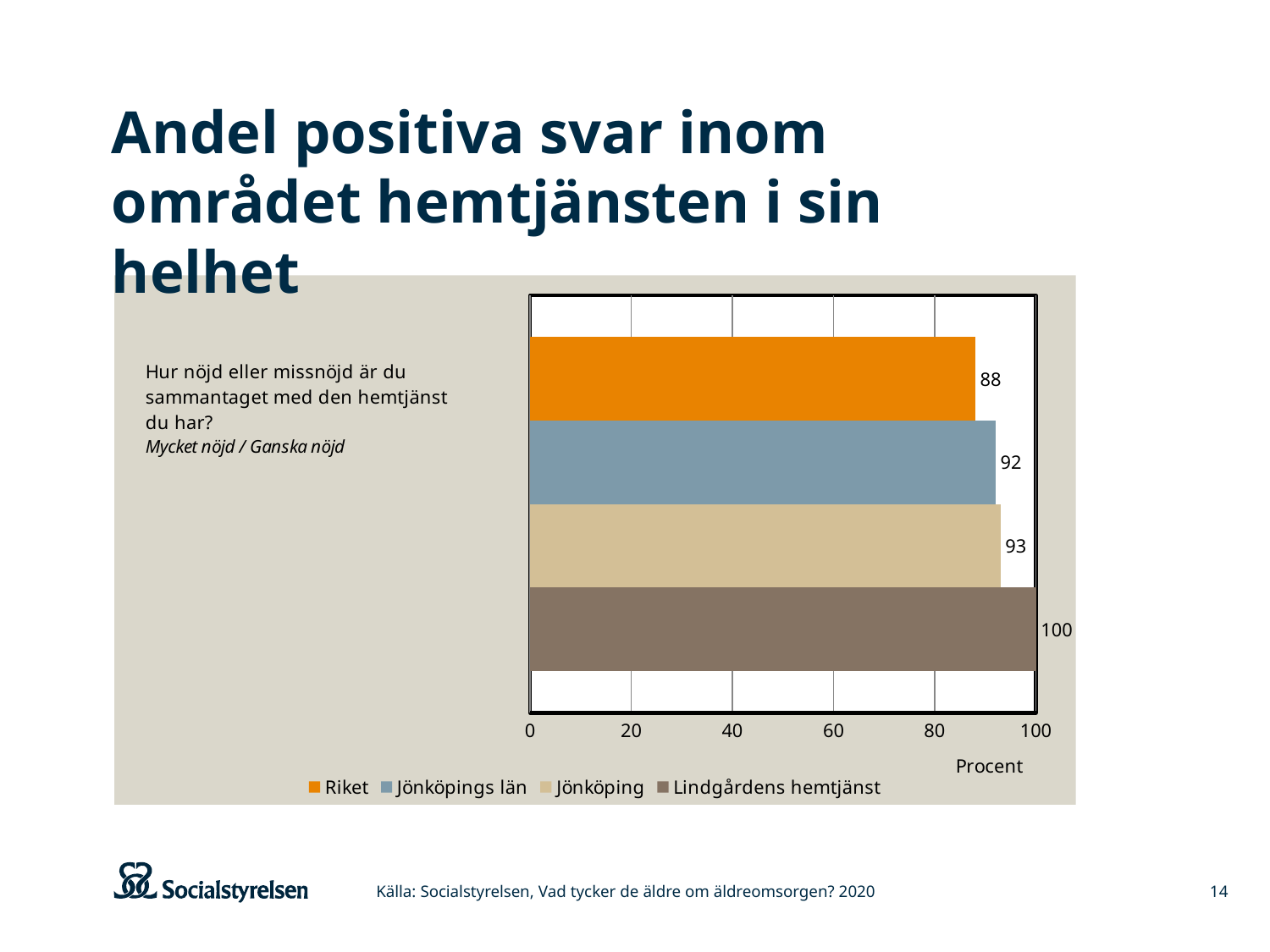
What is the label of the x axis? Procent How many series does the legend list? 4 What is the value for Riket? 88 Which series has the highest value? Lindgårdens hemtjänst Which series has the lowest value? Riket What is the value for Lindgårdens hemtjänst? 100 Which is larger, the value for Riket or the value for Lindgårdens hemtjänst? Lindgårdens hemtjänst What kind of chart is shown on the slide? Bar chart What is the value for Jönköpings län? 92 What is the difference between the values for Lindgårdens hemtjänst and Riket? 12 What is the value for Jönköping? 93 What is the difference between the values for Jönköping and Jönköpings län? 1